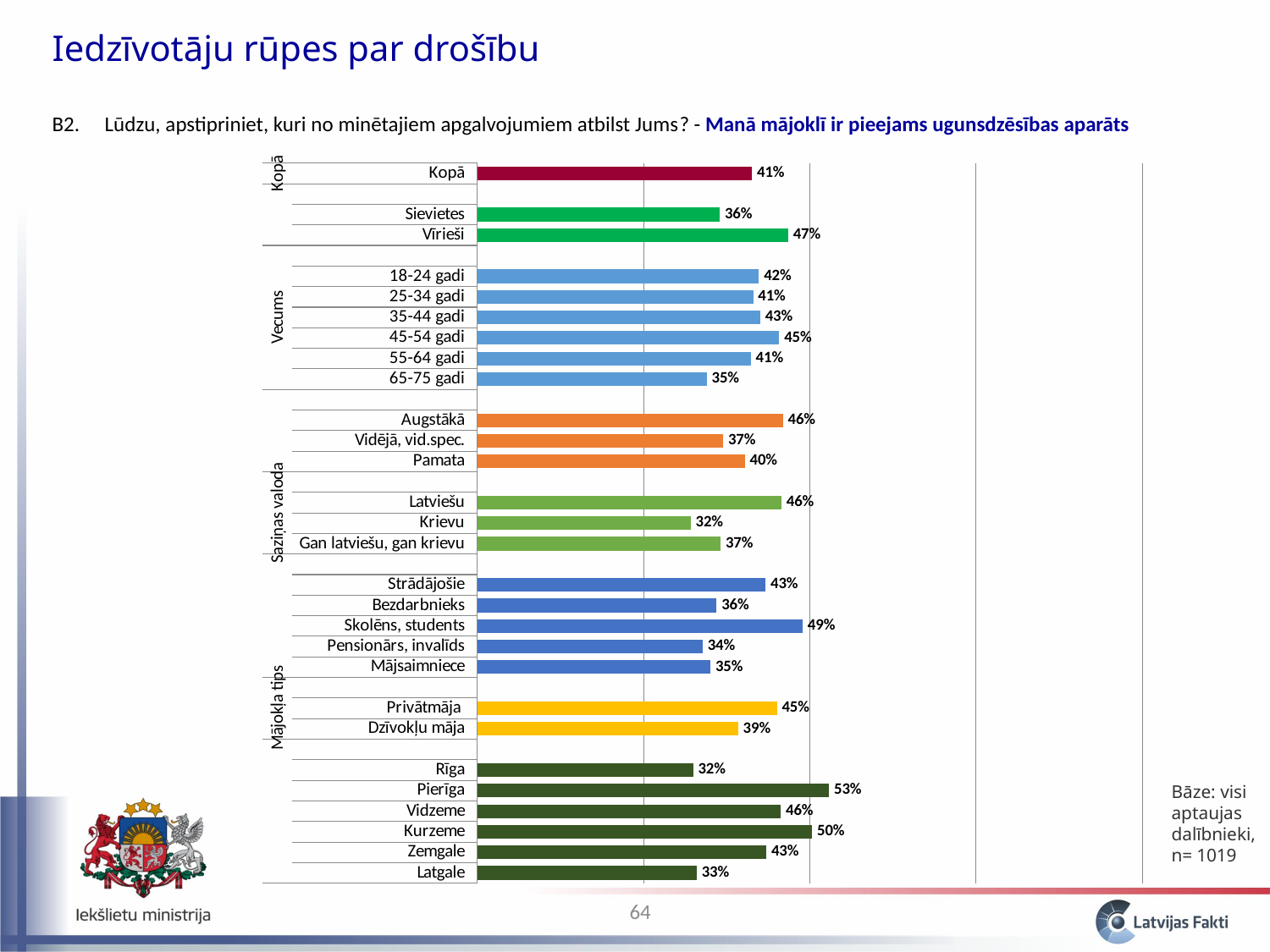
What is the value for Kopā? 41% What is the difference between the values for Pierīga and Latgale? 20% Which category has the highest value in the chart? Pierīga Among the regions (Rīga, Pierīga, Vidzeme, Kurzeme, Zemgale, Latgale), which has the lowest value? Rīga What type of chart is shown on the slide? Bar chart What is the difference between the values for Vīrieši and Sievietes? 11% How many bars are plotted in the chart? 28 Which is larger, the value for Privātmāja or Dzīvokļu māja? Privātmāja Which age group has the lowest value? 65-75 gadi What is the value for Skolēns, students? 49% What is the value for Krievu? 32% What colour is the bar for Kopā? Dark red